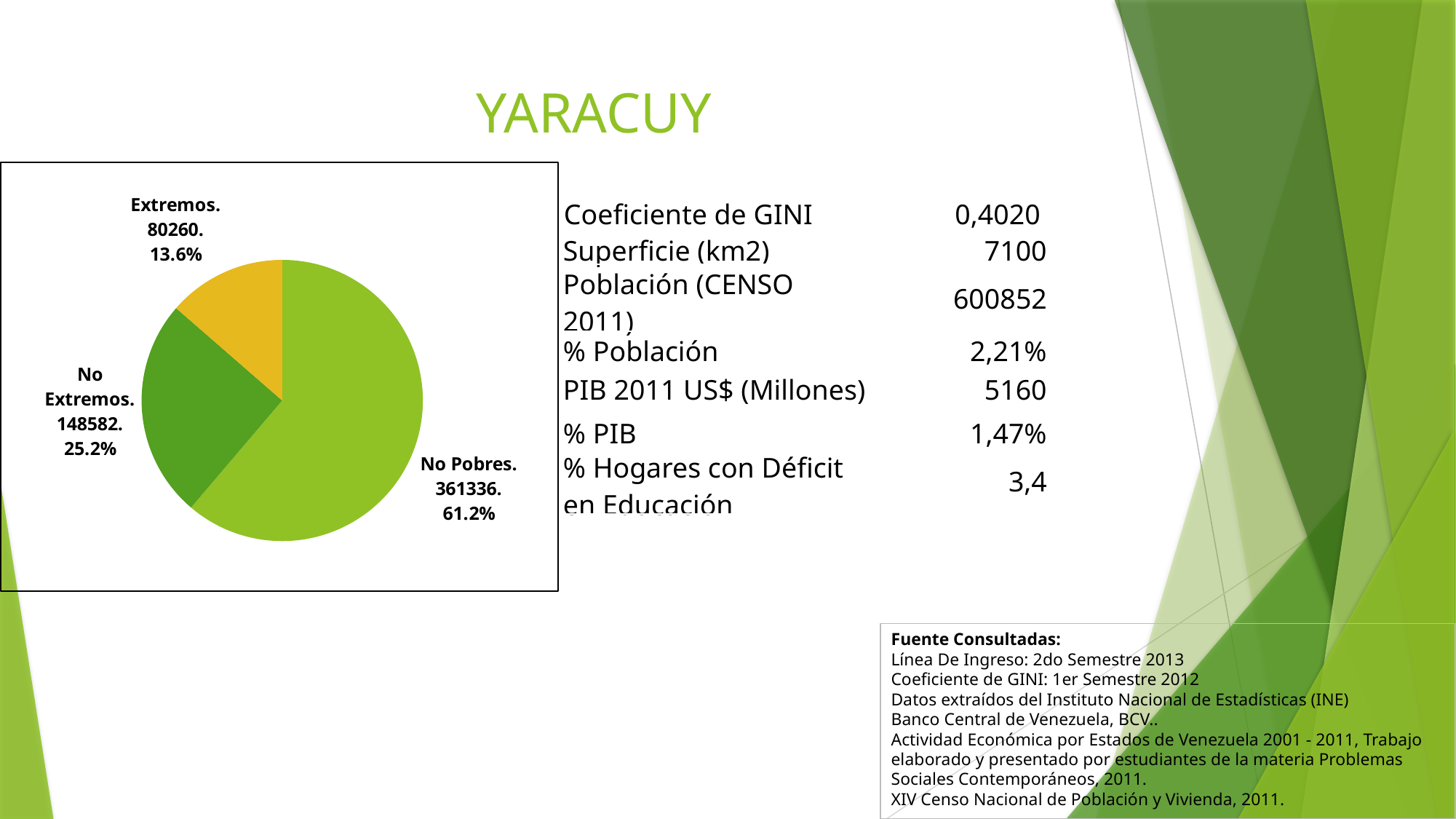
What share of the pie does the Extremos slice represent? 13.6% Which slice of the pie chart is the smallest? Extremos What colour is the Extremos slice of the pie chart? yellow What value is shown for the Extremos slice? 80260 What share of the pie does the No Pobres slice represent? 61.2% Which is larger, the No Extremos slice or the Extremos slice? No Extremos How many slices does the pie chart have? 3 Which slice of the pie chart is the largest? No Pobres What value is shown for the No Pobres slice? 361336 What is the difference between the No Extremos value and the Extremos value? 68322 What kind of chart is shown on the slide? pie chart What value is shown for the No Extremos slice? 148582